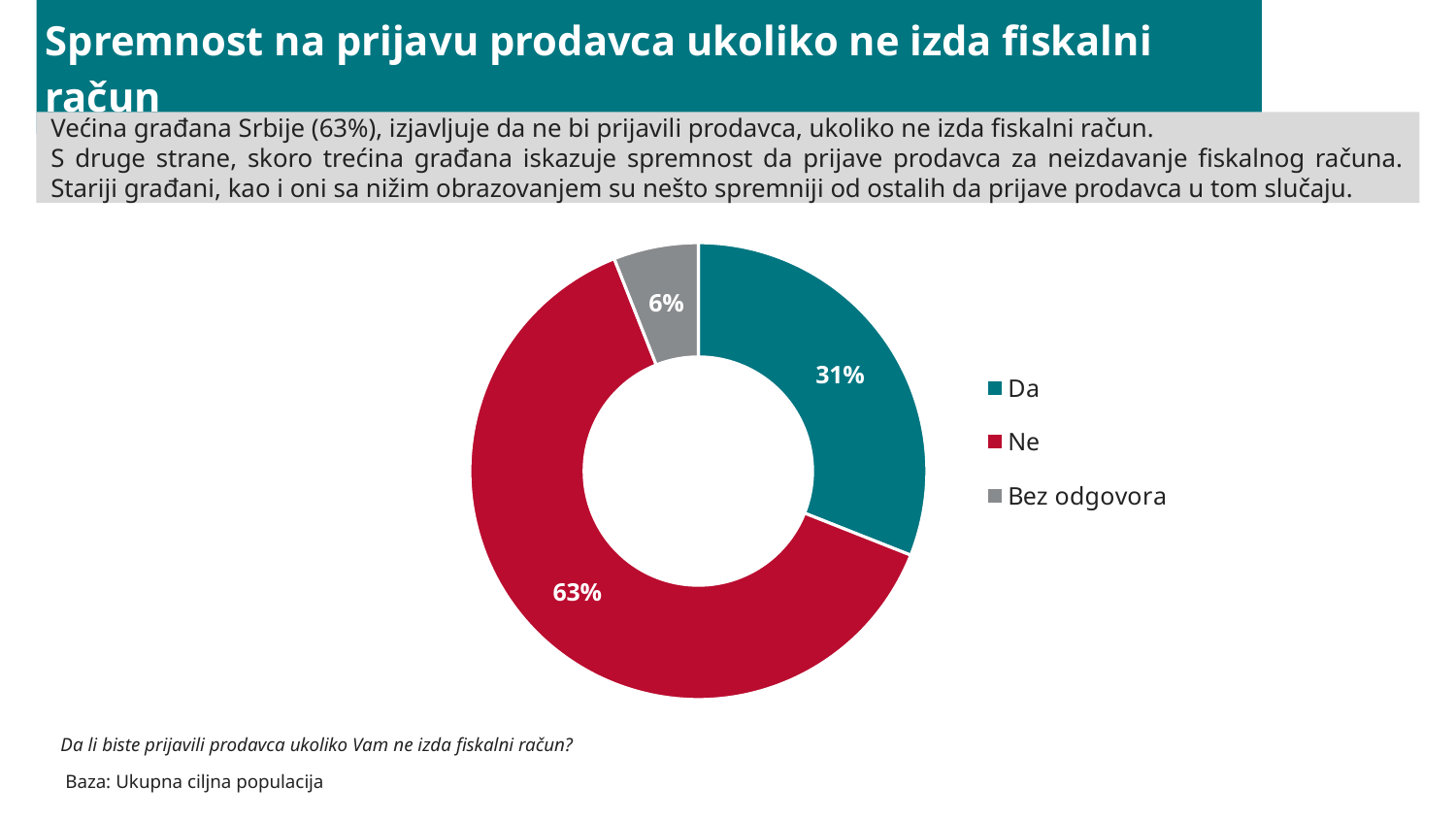
What colour represents the "Ne" category in the chart? Red Which is larger, the share for "Da" or the share for "Bez odgovora"? Da What percentage of respondents gave "Bez odgovora"? 6% What is the difference in percentage points between "Ne" and "Da"? 32 How many entries does the legend list? 3 What is the combined share of "Da" and "Ne"? 94% What percentage of respondents answered "Ne"? 63% What kind of chart is shown on the slide? Pie chart (doughnut) How many categories are shown in the chart? 3 Which category has the largest share of the chart? Ne Which category has the smallest share of the chart? Bez odgovora What percentage of respondents answered "Da"? 31%